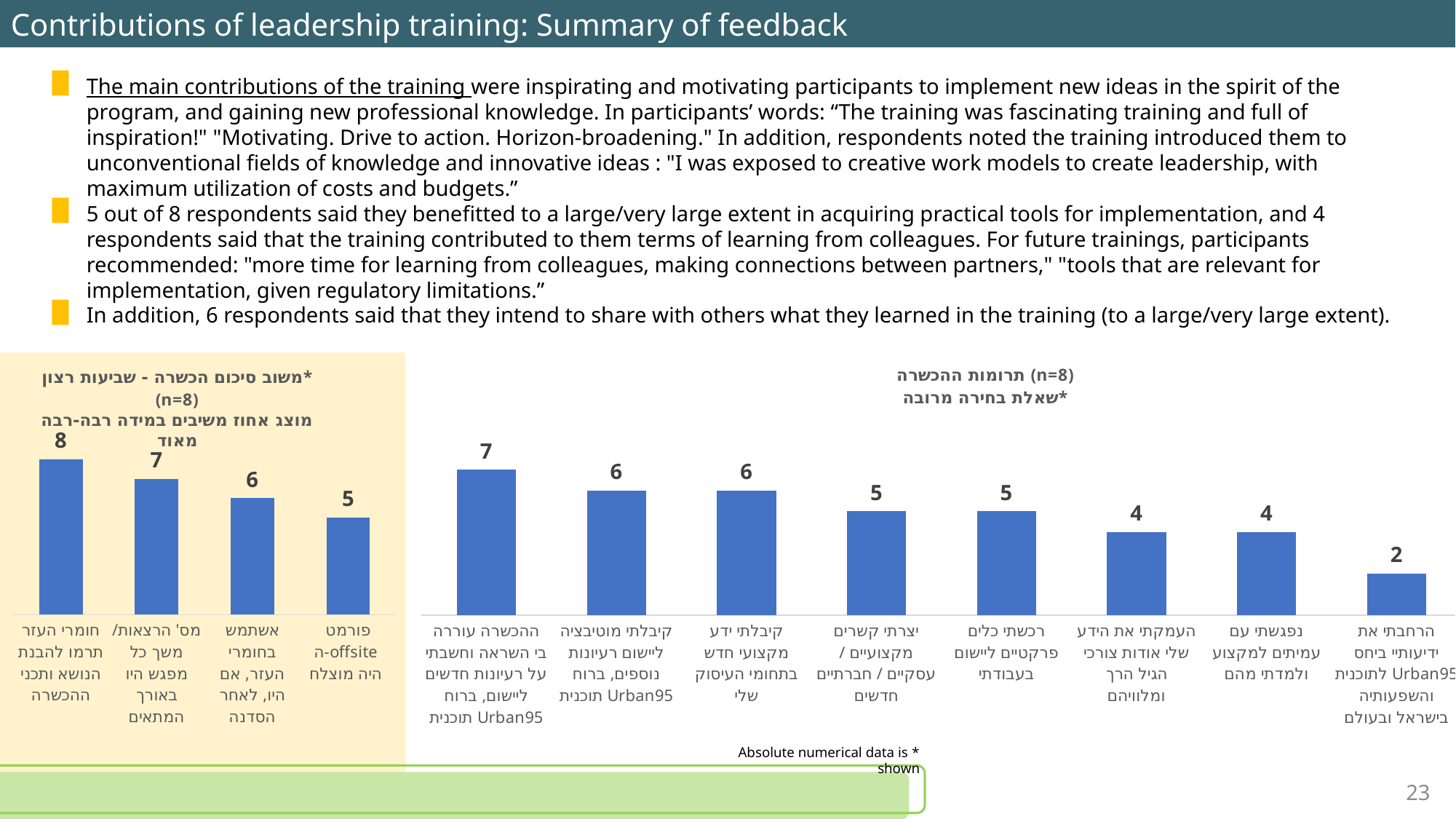
In the left chart (משוב סיכום הכשרה - שביעות רצון), what is the difference between the highest and lowest values? 3 What type of chart is the right chart (תרומות ההכשרה)? Bar chart In the right chart (תרומות ההכשרה), which is larger: 'קיבלתי מוטיבציה ליישום רעיונות נוספים' or 'העמקתי את הידע שלי אודות צורכי הגיל הרך ומלוויהם'? קיבלתי מוטיבציה ליישום רעיונות נוספים In the right chart (תרומות ההכשרה), which category has the highest value? ההכשרה עוררה בי השראה וחשבתי על רעיונות חדשים ליישום, ברוח תוכנית Urban95 In the right chart (תרומות ההכשרה), what is the value for 'רכשתי כלים פרקטיים ליישום בעבודתי'? 5 In the right chart (תרומות ההכשרה), what is the difference between 'קיבלתי ידע מקצועי חדש בתחומי העיסוק שלי' and 'נפגשתי עם עמיתים למקצוע ולמדתי מהם'? 2 In the left chart (משוב סיכום הכשרה - שביעות רצון), what is the value for 'פורמט ה-offsite היה מוצלח'? 5 In the left chart (משוב סיכום הכשרה - שביעות רצון), how many bars are shown? 4 In the left chart (משוב סיכום הכשרה - שביעות רצון), which category has the highest value? חומרי העזר תרמו להבנת הנושא ותכני ההכשרה In the right chart (תרומות ההכשרה), do the values rise or fall from left to right? Fall In the right chart (תרומות ההכשרה), how many categories are shown? 8 In the right chart (תרומות ההכשרה), which category has the lowest value? הרחבתי את ידיעותיי ביחס לתוכנית Urban95 והשפעותיה בישראל ובעולם